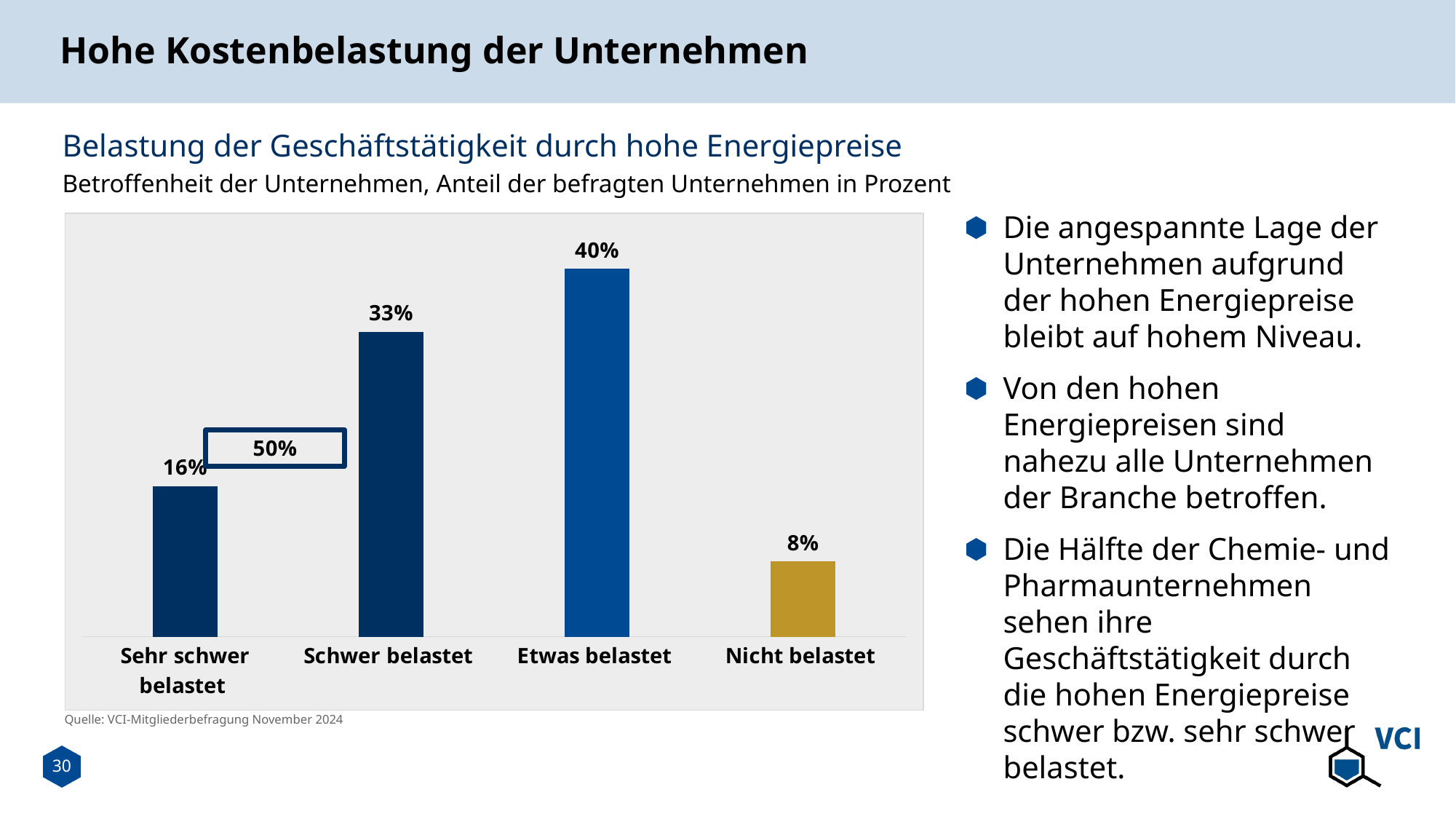
What is the value for "Nicht belastet"? 8% What is the source given below the chart? VCI-Mitgliederbefragung November 2024 Which category has the highest value? Etwas belastet Which category has the lowest value? Nicht belastet What is the value for "Schwer belastet"? 33% What is the value for "Sehr schwer belastet"? 16% How many categories are shown in the chart? 4 Which is larger, the value for "Sehr schwer belastet" or the value for "Nicht belastet"? Sehr schwer belastet What is the difference between the values for "Etwas belastet" and "Schwer belastet"? 7% What combined value is shown in the box above the first two bars? 50% What is the value for "Etwas belastet"? 40% What kind of chart is shown on the slide? Bar chart